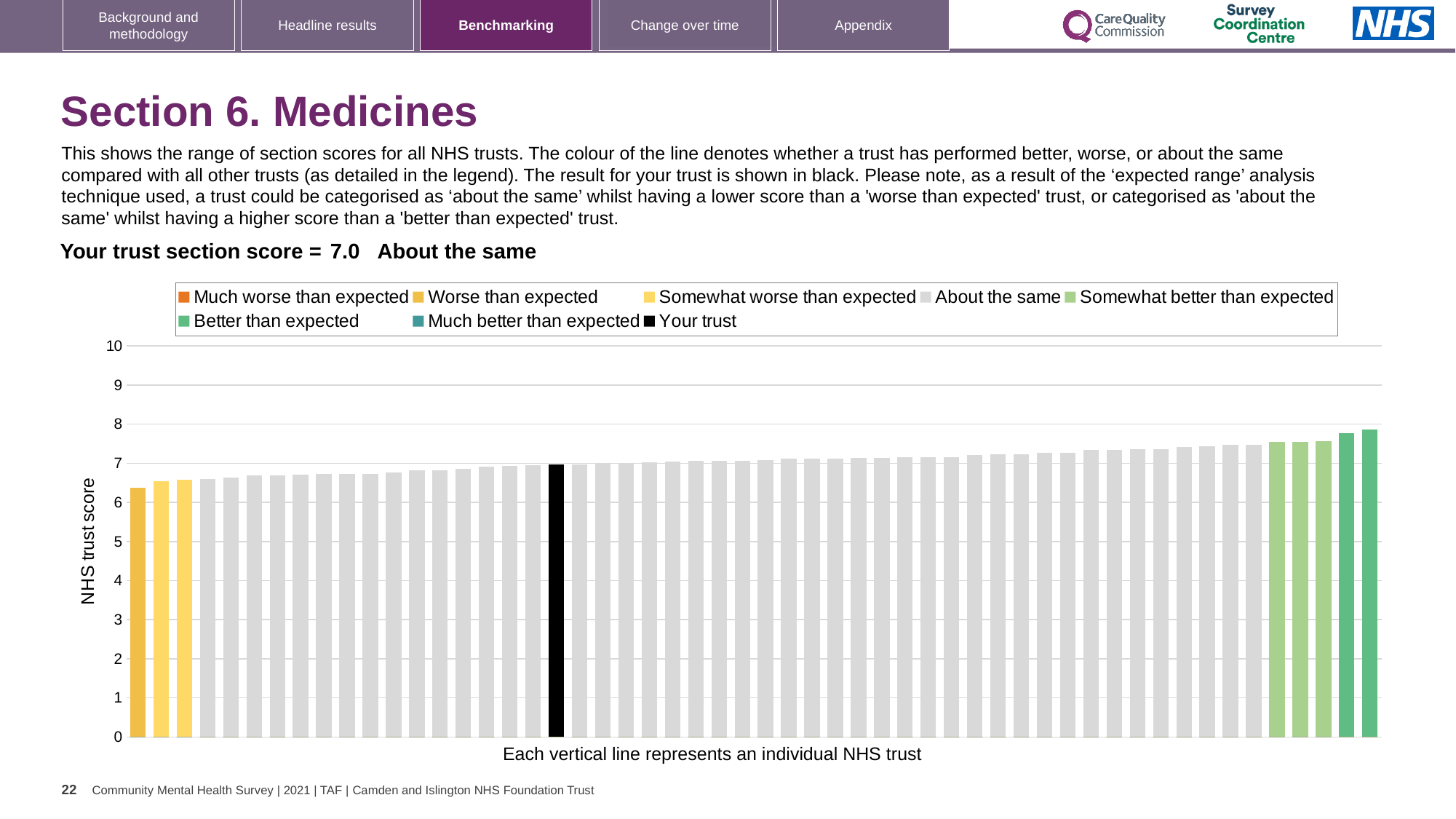
Is the value of the leftmost (lowest) bar greater or less than 6? greater Is the value of the rightmost (highest) bar greater or less than 8? less Is the value of the black 'Your trust' bar greater or less than 8? less What kind of chart is shown on the slide? bar chart Which category is the trust's section score placed in, according to the text above the chart? About the same How many bars are coloured as 'Better than expected' (dark green)? 2 How many bars are coloured as 'Somewhat better than expected' (light green)? 3 What is the label on the y axis of the chart? NHS trust score Is the black 'Your trust' bar higher or lower than the rightmost bar? lower Do the bar values rise or fall from left to right along the x axis? rise How many entries does the chart legend list? 8 What is the section score for your trust shown on the slide? 7.0